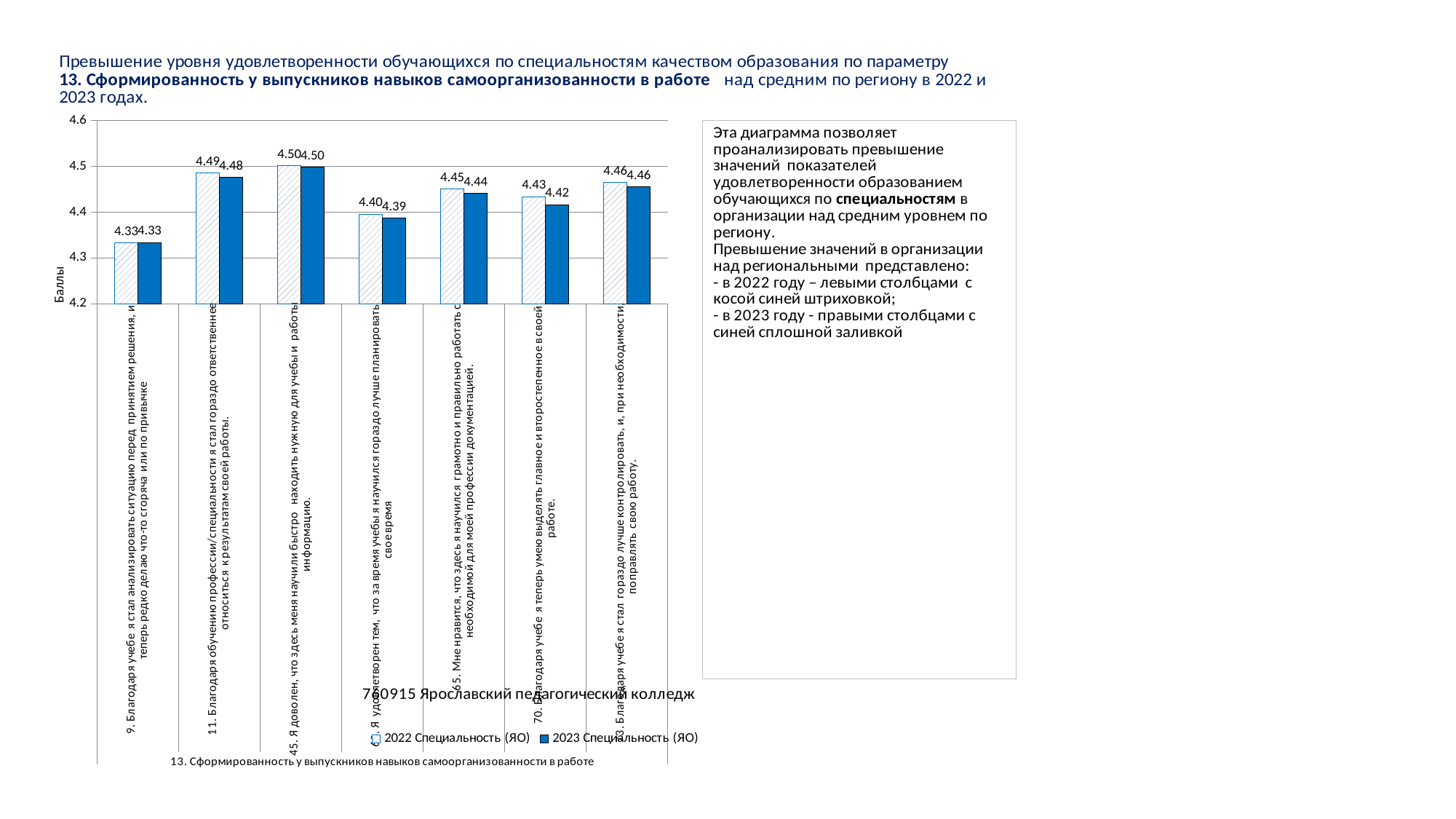
How many series does the legend list? 2 What is the label of the first legend entry? 2022 Специальность (ЯО) Which statement has the highest 2023 value? 45. Я доволен, что здесь меня научили быстро находить нужную для учебы и работы информацию What type of chart is shown on the slide? bar chart What is the 2023 value for statement 11 ("Благодаря обучению профессии/специальности я стал гораздо ответственнее...")? 4.48 Which statement has the lowest 2022 value? 9. Благодаря учебе я стал анализировать ситуацию перед принятием решения, и теперь редко делаю что-то сгоряча или по привычке What is the 2022 value for statement 45 ("Я доволен, что здесь меня научили быстро находить нужную для учебы и работы информацию")? 4.50 What is the difference between the 2022 value for statement 45 and the 2022 value for statement 9? 0.17 How many categories (statements) are plotted on the chart? 7 What is the 2022 value for statement 9 ("Благодаря учебе я стал анализировать ситуацию перед принятием решения...")? 4.33 What is the 2023 value for statement 70 ("Благодаря учебе я теперь умею выделять главное и второстепенное в своей работе")? 4.42 For statement 65 ("Мне нравится, что здесь я научился грамотно и правильно работать с необходимой для моей профессии документацией"), which year has the larger value, 2022 or 2023? 2022